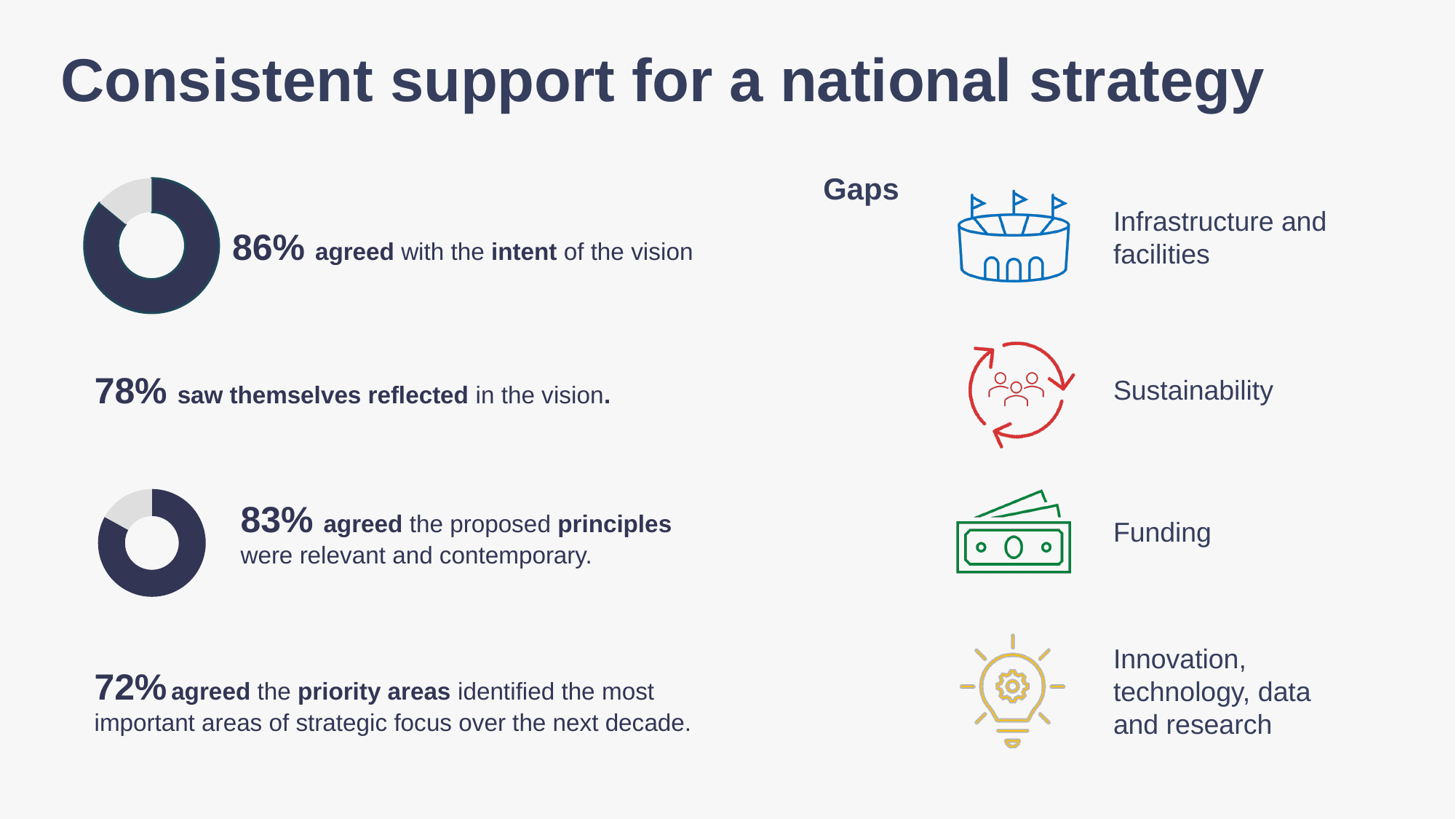
What is the difference in percentage points between the share shown in the top donut chart (86%) and the share shown in the lower donut chart (83%)? 3 percentage points How many segments does the top donut chart (86% agreed with the intent of the vision) have? 2 Which donut chart shows the larger filled share: the one for the intent of the vision or the one for the proposed principles? The intent of the vision (86%) In the top donut chart, is the filled share for agreement with the intent of the vision greater or less than 80%? greater In the lower donut chart, is the filled share for agreement with the proposed principles greater or less than 90%? less How many donut charts are shown on the slide? 2 What kind of chart is shown next to the statement about the intent of the vision? Donut chart What colour is the remaining (non-agreed) portion of the donut charts on the slide? Light grey In the lower donut chart, what share of respondents agreed the proposed principles were relevant and contemporary? 83% In the top donut chart, what share of respondents agreed with the intent of the vision? 86% In the top donut chart, what share of respondents did not agree with the intent of the vision? 14% What colour is the filled (agreed) portion of the donut charts on the slide? Dark navy blue